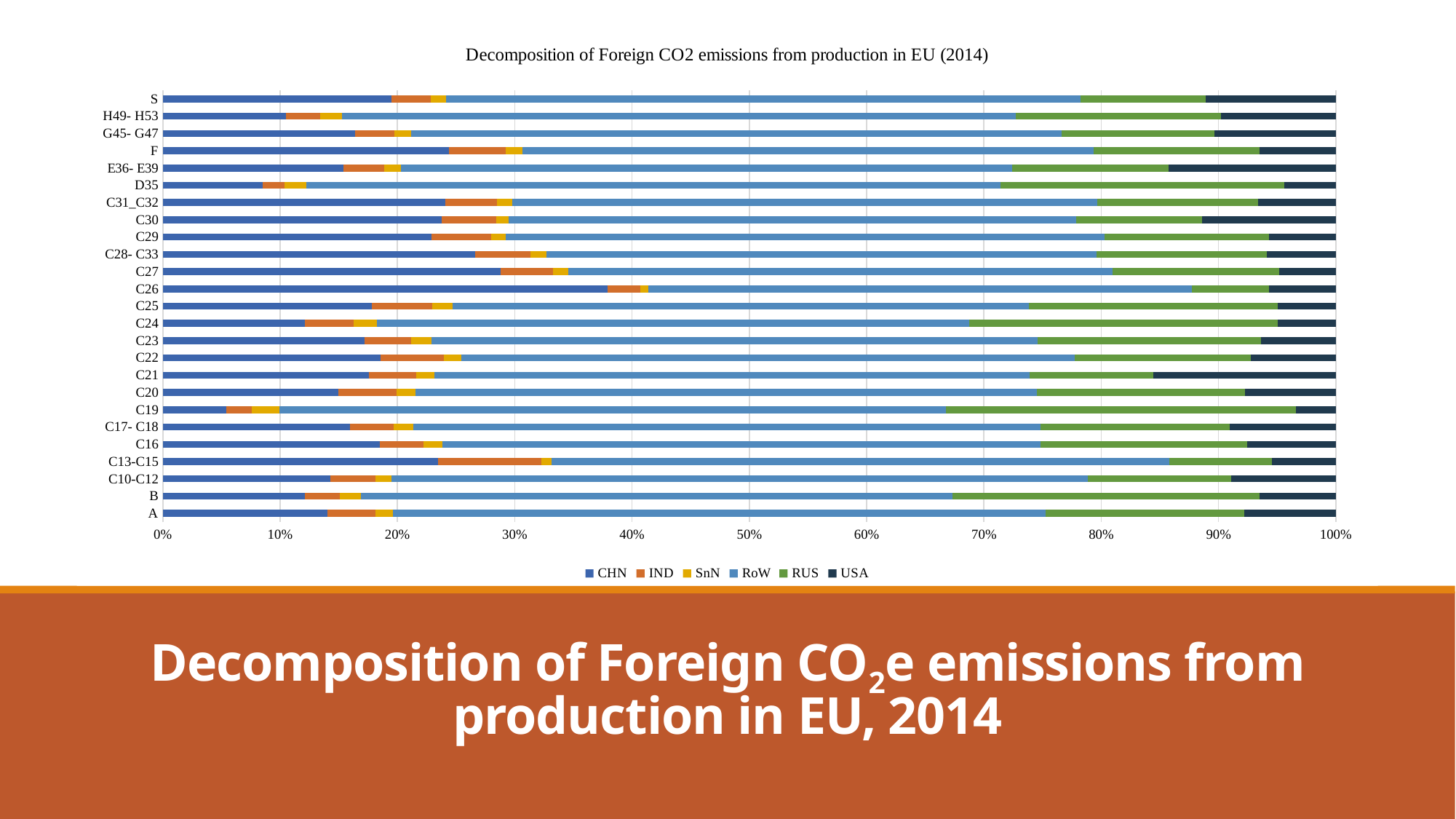
Which category has the largest CHN share in the chart? C26 What is the title of the chart? Decomposition of Foreign CO2 emissions from production in EU (2014) Which series is listed last in the chart legend? USA Is the CHN share for D35 greater or less than 10%? less Is the CHN share for C19 greater or less than 10%? less How many series does the chart legend list? 6 Is the CHN share for C26 greater or less than 30%? greater Which category has the smallest CHN share in the chart? C19 What kind of chart is shown on the slide? Stacked bar chart Which category has the larger CHN share, C26 or C19? C26 How many categories (sectors) are plotted on the vertical axis of the chart? 25